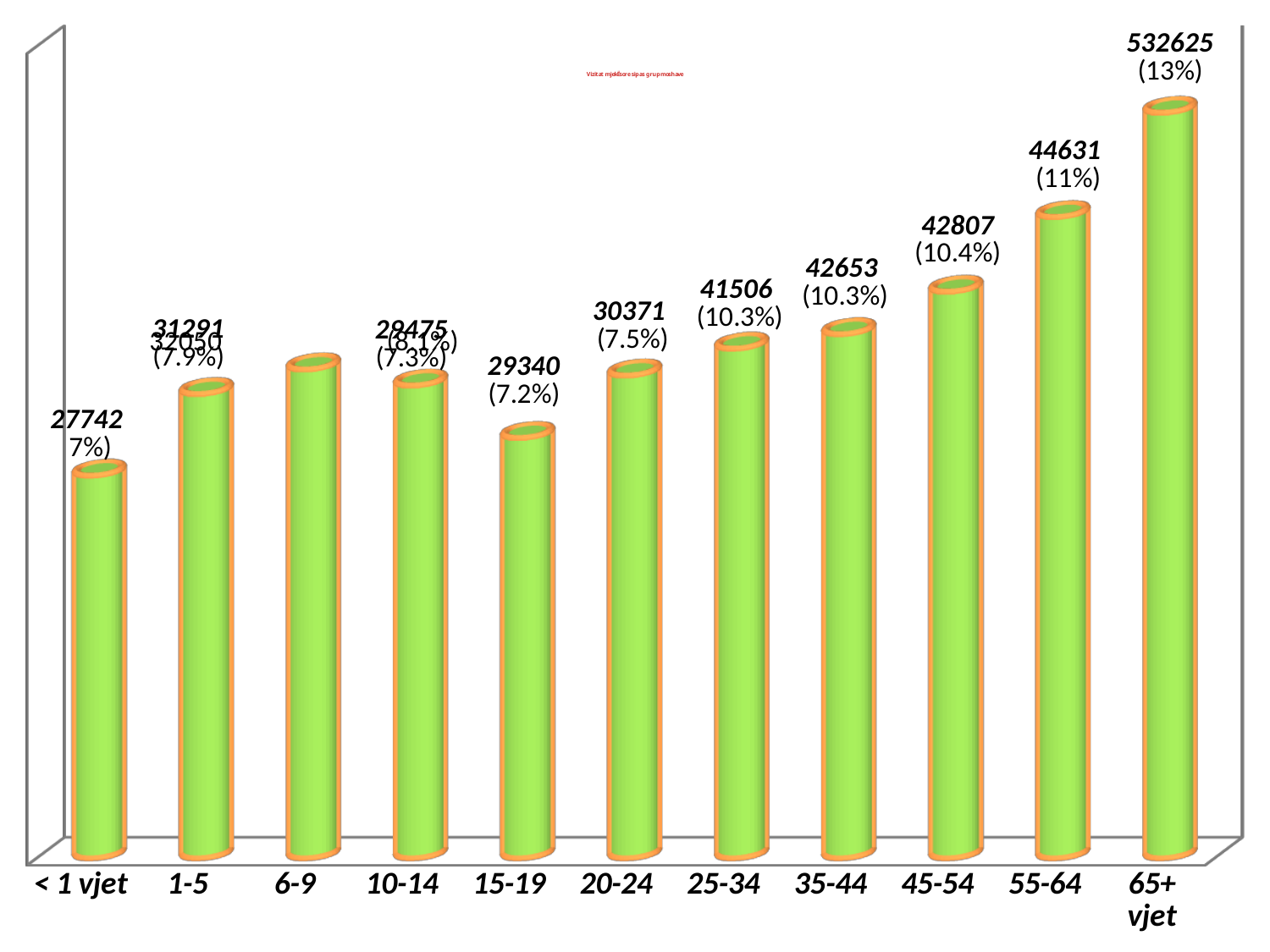
Which age group has the lowest value? < 1 vjet What is the value for the 55-64 age group? 44631 How many age groups are shown on the chart? 11 What is the value for the 15-19 age group? 29340 Which age group has the highest value? 65+ vjet What percentage is shown for the 65+ vjet age group? 13% What is the value for the 65+ vjet age group? 532625 What percentage is shown for the 45-54 age group? 10.4% What is the difference between the values for 55-64 and 45-54? 1824 What kind of chart is shown on the slide? bar chart What is the value for the 25-34 age group? 41506 Which has the larger value, 20-24 or 15-19? 20-24